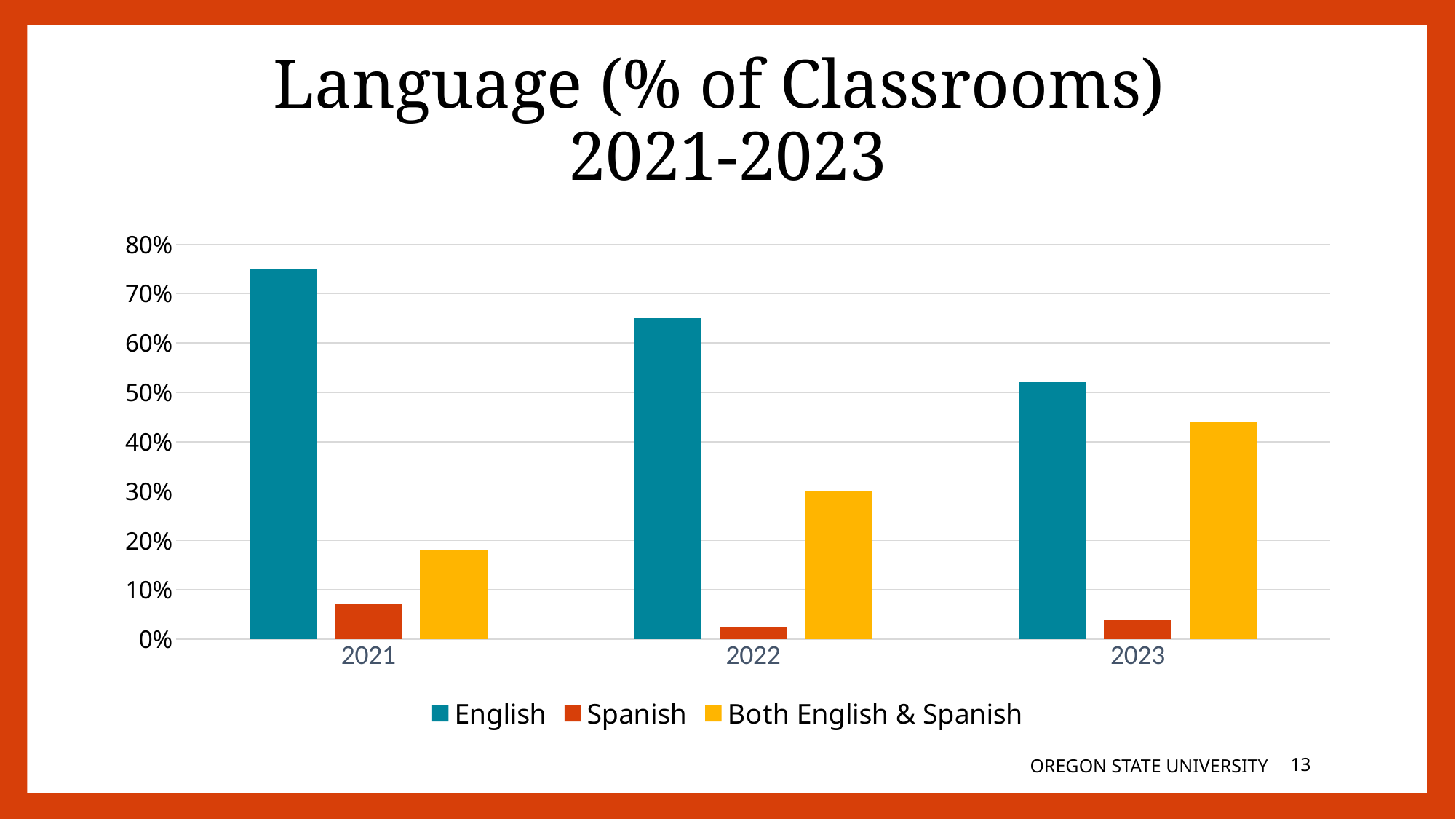
Is the value for English in 2022 greater or less than 60%? greater Is the value for Spanish in 2021 greater or less than 10%? less Which is larger in 2022: Spanish or Both English & Spanish? Both English & Spanish Is the value for English in 2021 greater or less than 70%? greater Does the value for English rise or fall from 2021 to 2023? fall Which series has the highest value in 2023? English Which series has the lowest value in 2022? Spanish How many years are shown on the x axis? 3 How many series does the legend list? 3 What kind of chart is shown on the slide? bar chart